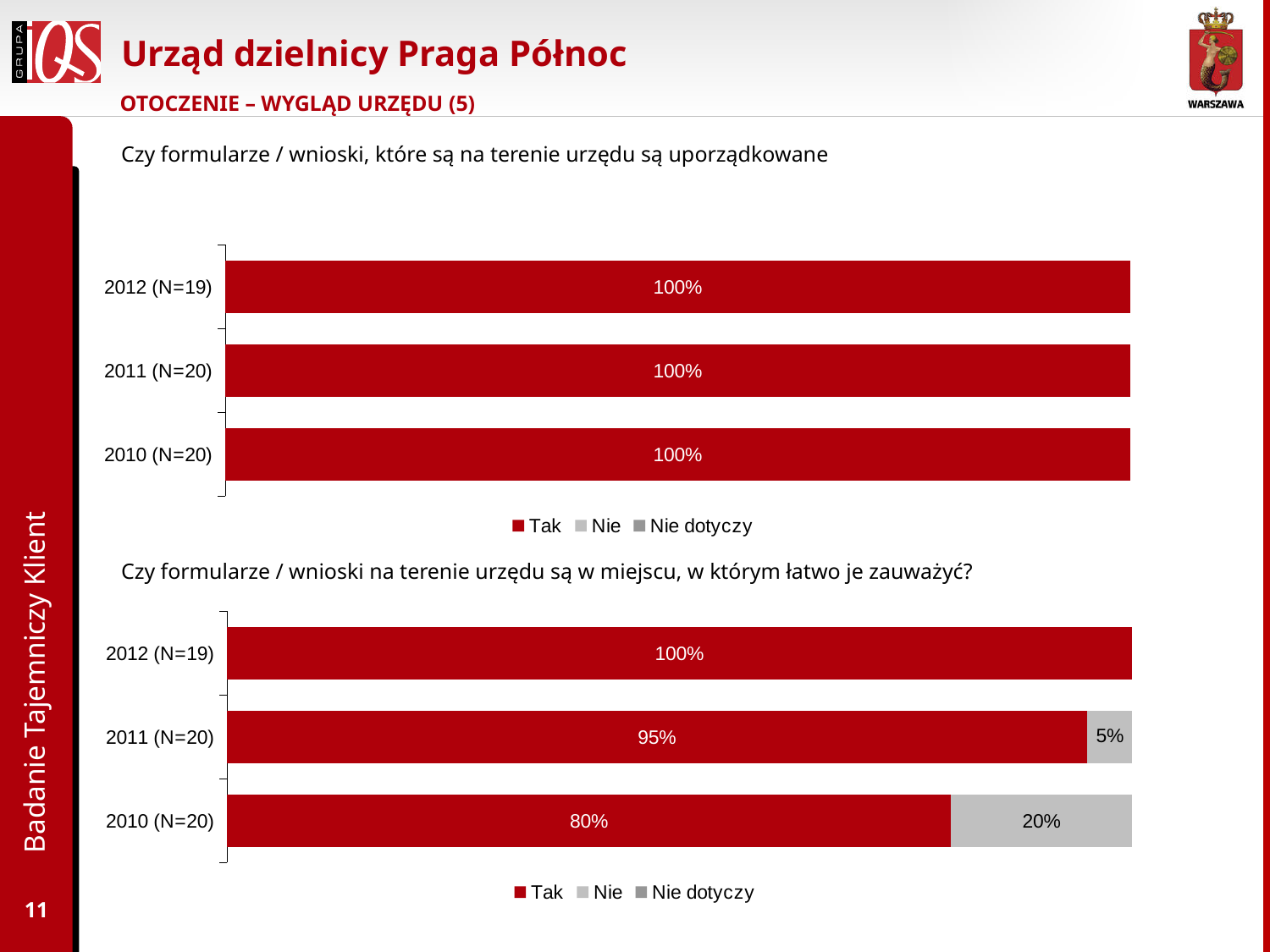
In the bottom chart ("Czy formularze / wnioski na terenie urzędu są w miejscu, w którym łatwo je zauważyć?"), what is the "Nie" value for 2011 (N=20)? 5% In the bottom chart ("Czy formularze / wnioski na terenie urzędu są w miejscu, w którym łatwo je zauważyć?"), which year has the lowest "Tak" value? 2010 (N=20) In the bottom chart ("Czy formularze / wnioski na terenie urzędu są w miejscu, w którym łatwo je zauważyć?"), what is the "Tak" value for 2010 (N=20)? 80% How many series does the legend of the bottom chart ("Czy formularze / wnioski na terenie urzędu są w miejscu, w którym łatwo je zauważyć?") list? 3 How many year categories does the top chart ("Czy formularze / wnioski, które są na terenie urzędu są uporządkowane") show? 3 In the bottom chart ("Czy formularze / wnioski na terenie urzędu są w miejscu, w którym łatwo je zauważyć?"), is the "Nie" value larger for 2010 (N=20) or 2011 (N=20)? 2010 (N=20) In the bottom chart ("Czy formularze / wnioski na terenie urzędu są w miejscu, w którym łatwo je zauważyć?"), which year has the highest "Tak" value? 2012 (N=19) In the bottom chart ("Czy formularze / wnioski na terenie urzędu są w miejscu, w którym łatwo je zauważyć?"), what is the difference between the "Tak" values for 2011 (N=20) and 2010 (N=20)? 15% What kind of chart is the top chart ("Czy formularze / wnioski, które są na terenie urzędu są uporządkowane")? bar chart In the bottom chart ("Czy formularze / wnioski na terenie urzędu są w miejscu, w którym łatwo je zauważyć?"), does the "Tak" value rise or fall from 2010 to 2012? rise In the bottom chart ("Czy formularze / wnioski na terenie urzędu są w miejscu, w którym łatwo je zauważyć?"), what is the "Nie" value for 2010 (N=20)? 20% In the top chart ("Czy formularze / wnioski, które są na terenie urzędu są uporządkowane"), what is the "Tak" value for 2011 (N=20)? 100%